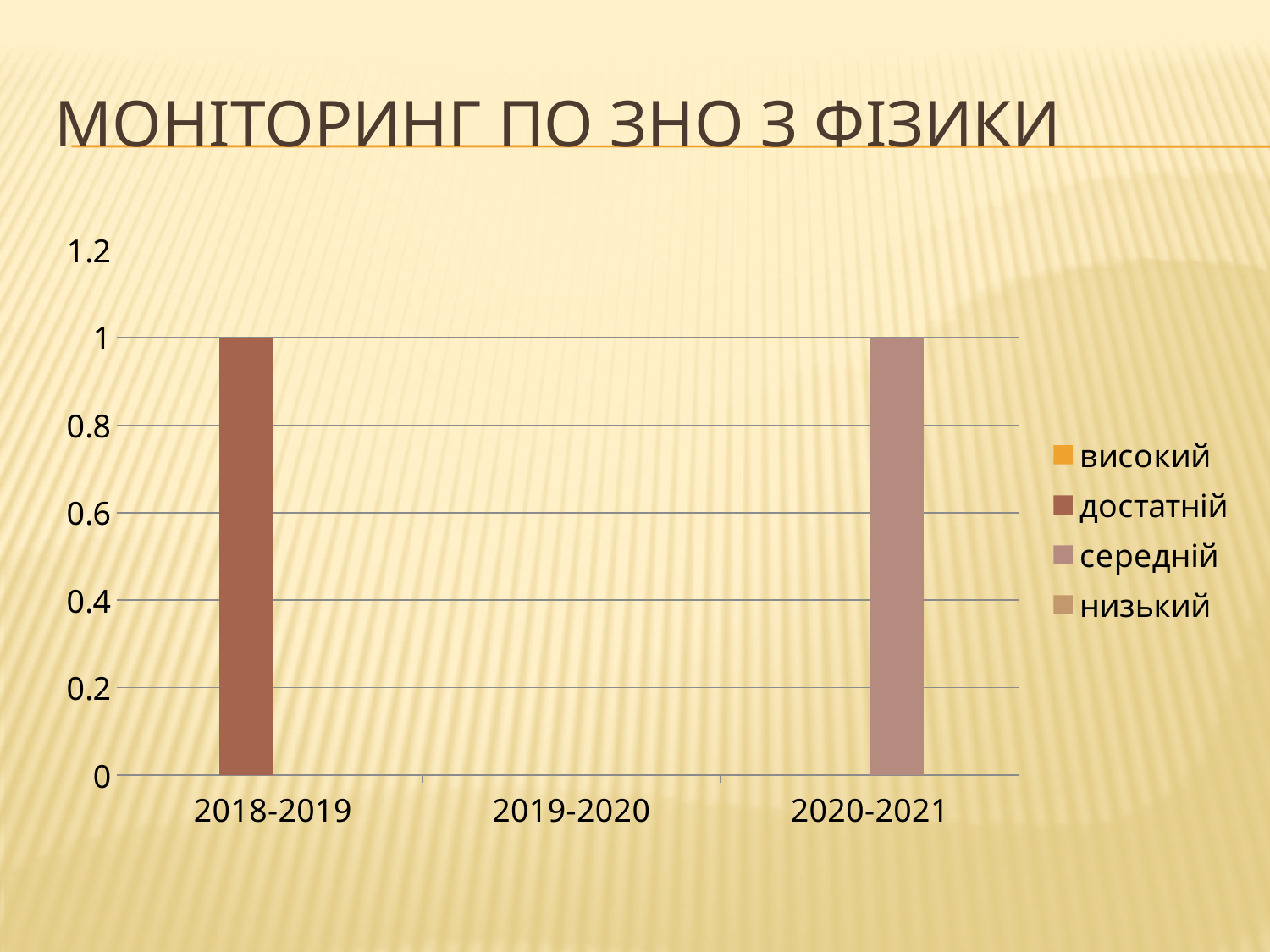
What is the value of the середній bar for 2020-2021? 1 What is the highest value shown on the y axis? 1.2 What is the value of the достатній bar for 2018-2019? 1 How many series does the legend list? 4 What kind of chart is shown on the slide? bar chart Is the value of the достатній bar for 2018-2019 greater or less than 0.8? greater Which series has a visible bar in the 2018-2019 category? достатній Which category has no visible bars? 2019-2020 Is the value of the середній bar for 2020-2021 greater or less than 1.2? less What is the title of the chart? МОНІТОРИНГ ПО ЗНО З ФІЗИКИ How many categories are shown on the x axis? 3 What is the difference between the достатній value for 2018-2019 and the середній value for 2020-2021? 0